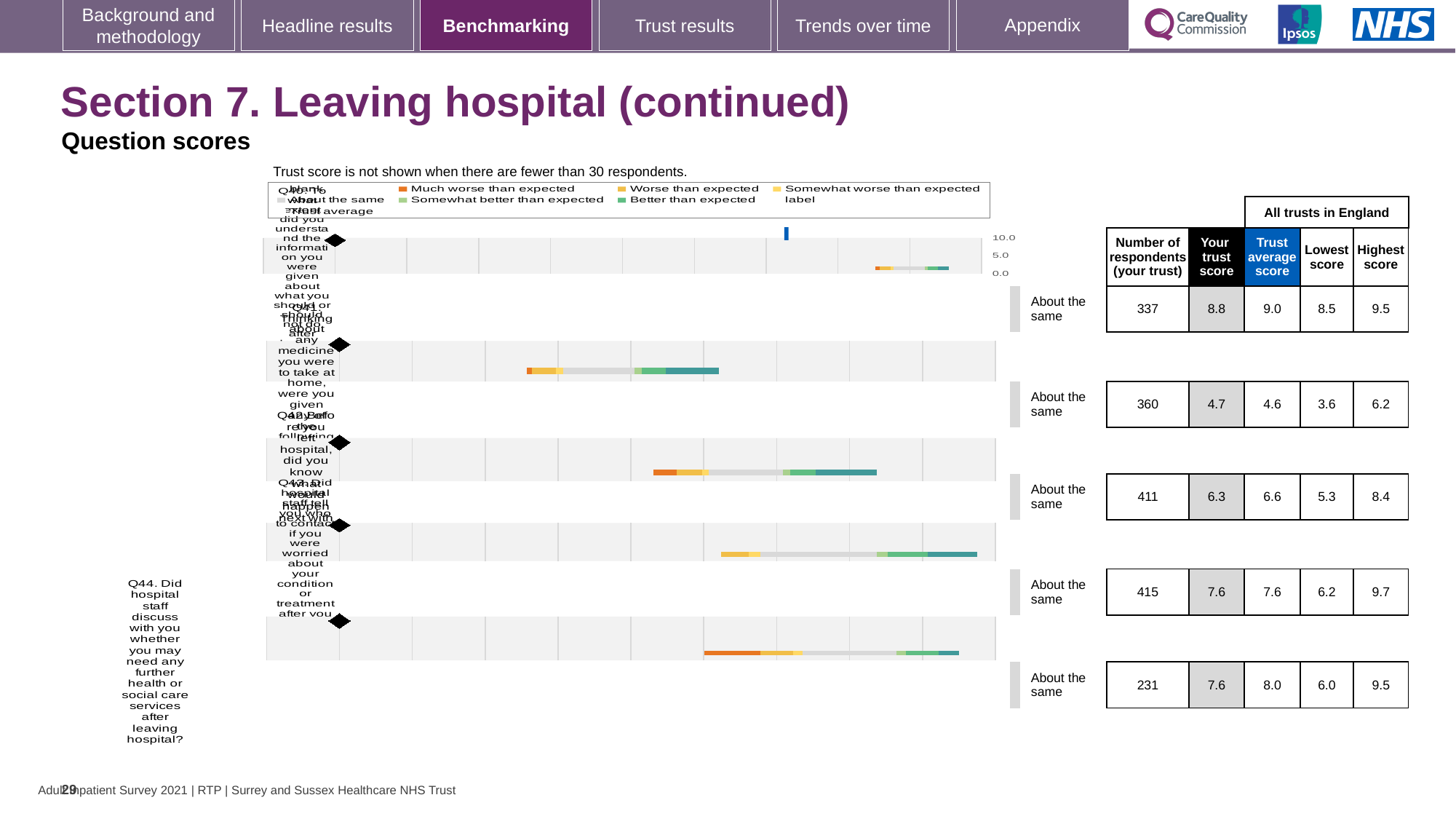
Which row of the question scores chart has the lowest 'Your trust score'? The second row, with 4.7 For Q44, what is the difference between the highest score and the lowest score across all trusts in England? 3.5 Is the trust score for Q44 greater or less than 5.0? greater For Q44, which is larger: the trust score or the trust average score? Trust average score What benchmark category label is shown next to every question in the chart? About the same What kind of chart is used to show the question scores on this slide? bar chart What is the number of respondents (your trust) for Q44, about discussing further health or social care services after leaving hospital? 231 What is the trust average score for Q44, about discussing further health or social care services after leaving hospital? 8.0 How many questions (rows) are plotted in the question scores chart? 5 What is the trust score for Q44, about discussing further health or social care services after leaving hospital? 7.6 What is the highest score across all trusts in England for Q44, about discussing further health or social care services after leaving hospital? 9.5 Which row of the question scores chart has the highest 'Your trust score'? The first (top) row, with 8.8